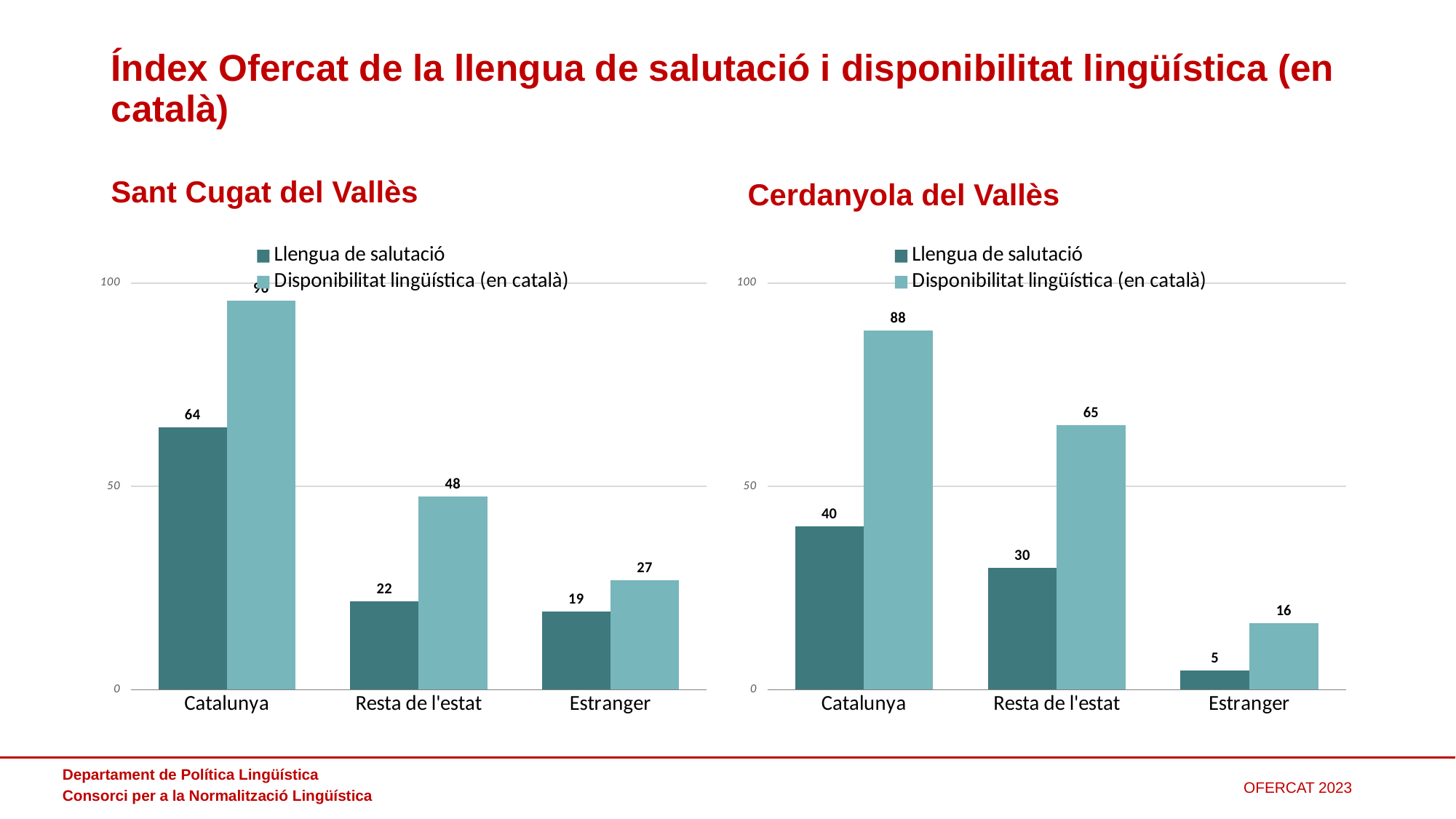
In the Cerdanyola del Vallès chart, what is the difference between Disponibilitat lingüística (en català) and Llengua de salutació for Resta de l'estat? 35 In the Cerdanyola del Vallès chart, what is the value of Llengua de salutació for Estranger? 5 How many series does the legend of the Cerdanyola del Vallès chart list? 2 In the Cerdanyola del Vallès chart, which category has the lowest Llengua de salutació value? Estranger Which is larger: Llengua de salutació for Resta de l'estat in Sant Cugat del Vallès or in Cerdanyola del Vallès? Cerdanyola del Vallès What type of chart is the Sant Cugat del Vallès chart? Bar chart In the Sant Cugat del Vallès chart, is the Disponibilitat lingüística (en català) value for Catalunya greater or less than 50? greater In the Cerdanyola del Vallès chart, what is the value of Disponibilitat lingüística (en català) for Catalunya? 88 In the Sant Cugat del Vallès chart, what is the difference between Disponibilitat lingüística (en català) and Llengua de salutació for Estranger? 8 In the Sant Cugat del Vallès chart, what is the value of Llengua de salutació for Catalunya? 64 In the Sant Cugat del Vallès chart, what is the value of Disponibilitat lingüística (en català) for Resta de l'estat? 48 In the Sant Cugat del Vallès chart, what is the value of Llengua de salutació for Estranger? 19